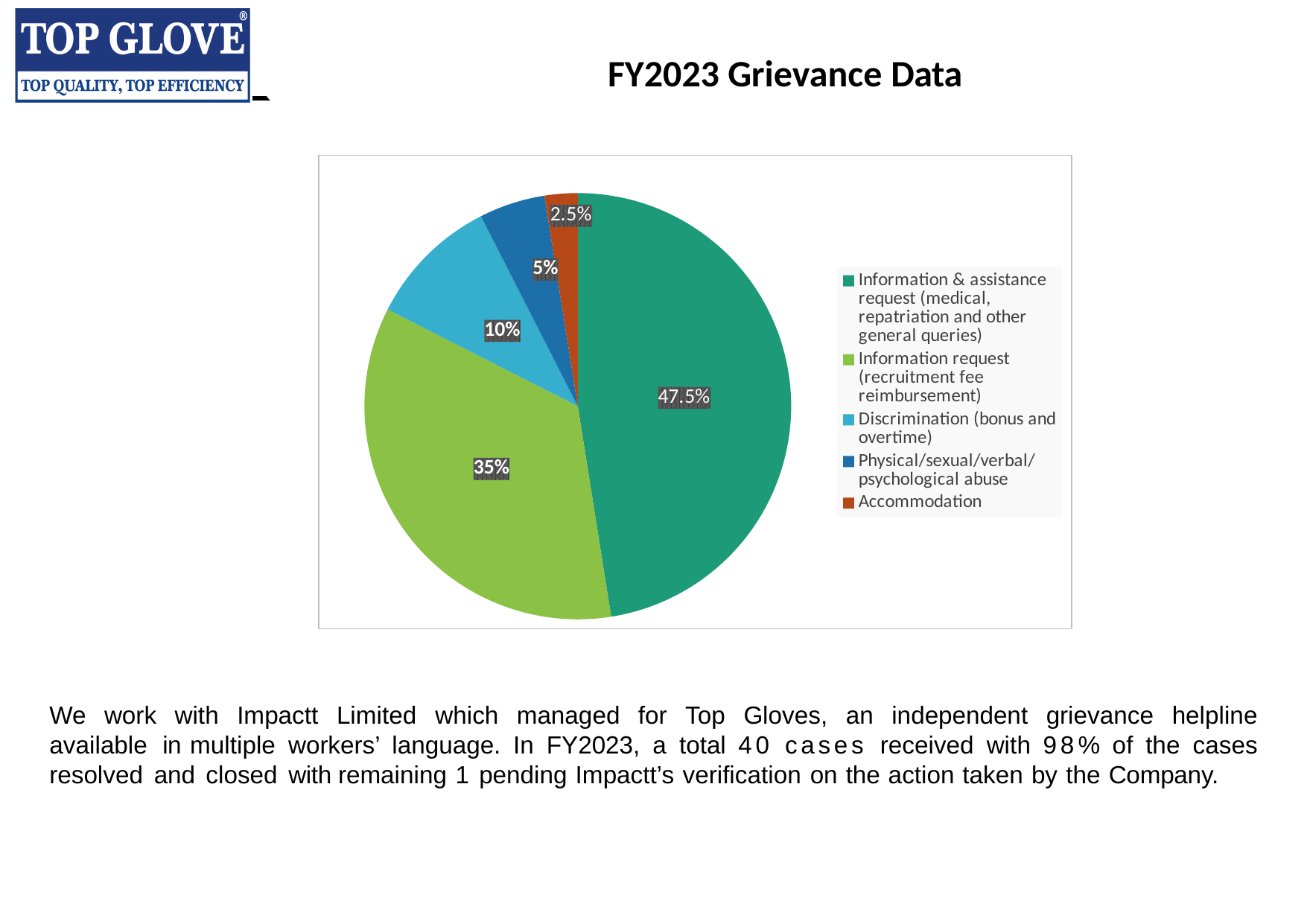
What is the title of the chart on the slide? FY2023 Grievance Data What share of grievances is Information & assistance request (medical, repatriation and other general queries)? 47.5% What share of grievances is Physical/sexual/verbal/psychological abuse? 5% Which category has the largest share of the pie? Information & assistance request (medical, repatriation and other general queries) What share of grievances is Discrimination (bonus and overtime)? 10% What share of grievances is Accommodation? 2.5% Which category has the smallest share of the pie? Accommodation What kind of chart is shown on the slide? Pie chart What is the difference in percentage points between the Information & assistance request slice and the Information request (recruitment fee reimbursement) slice? 12.5 What share of grievances is Information request (recruitment fee reimbursement)? 35% How many categories does the legend list? 5 Which is larger: the Discrimination (bonus and overtime) slice or the Physical/sexual/verbal/psychological abuse slice? Discrimination (bonus and overtime)